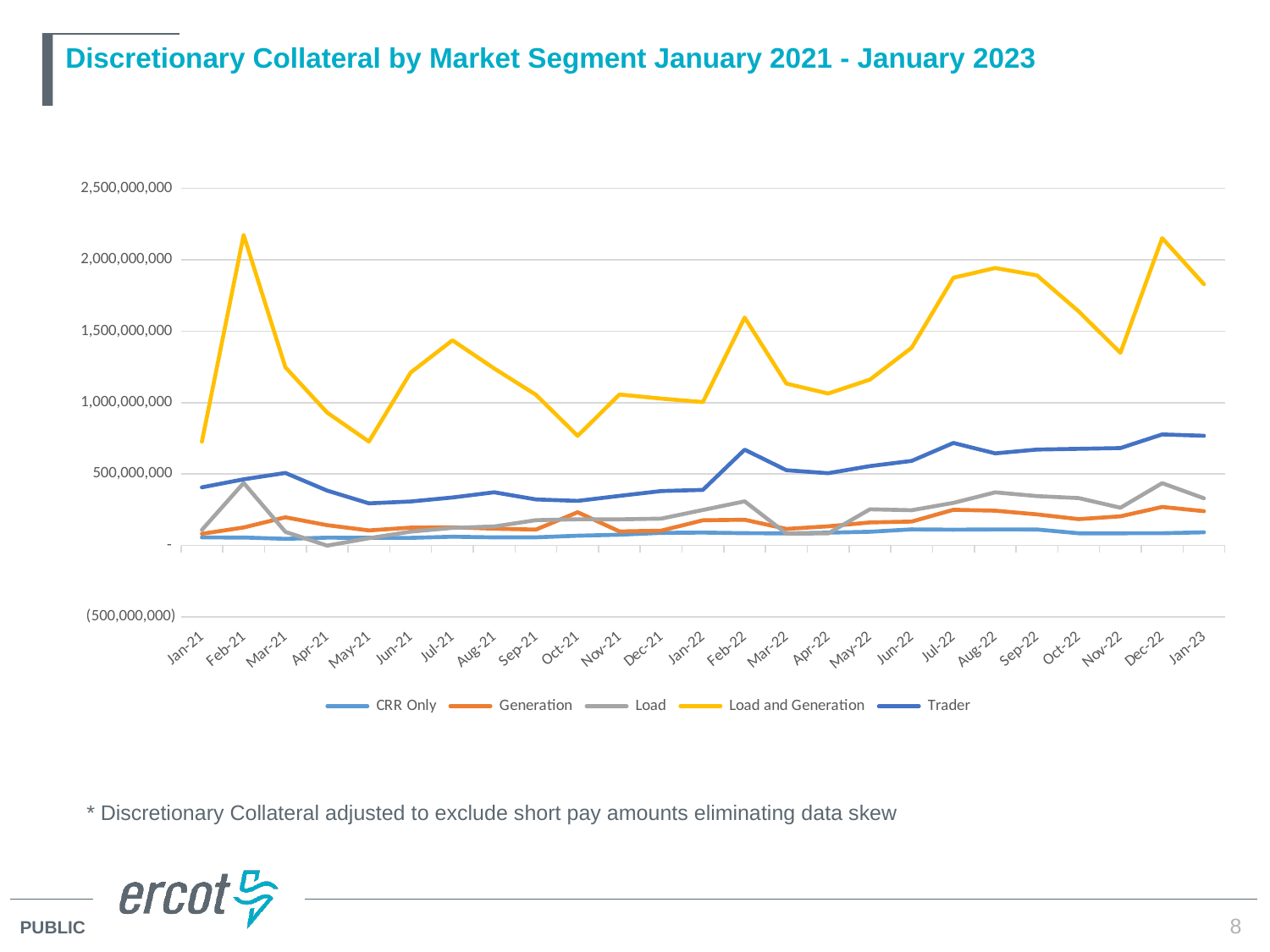
Which market segment has the highest value in Jan-23? Load and Generation What colour is the Load and Generation line in the legend? yellow How many series does the legend list? 5 Which is larger for Load and Generation: the value in Feb-22 or the value in Aug-22? Aug-22 Does the Trader series rise or fall overall from Jan-22 to Jan-23? rise Is the value for Load and Generation in Aug-22 greater or less than 1,500,000,000? greater How many months are plotted along the x axis? 25 What kind of chart is shown on the slide? line chart Which market segment has the lowest value in Jan-23? CRR Only Is the value for Load and Generation in May-21 greater or less than 1,000,000,000? less Is the value for Trader in Jan-23 greater or less than 500,000,000? greater